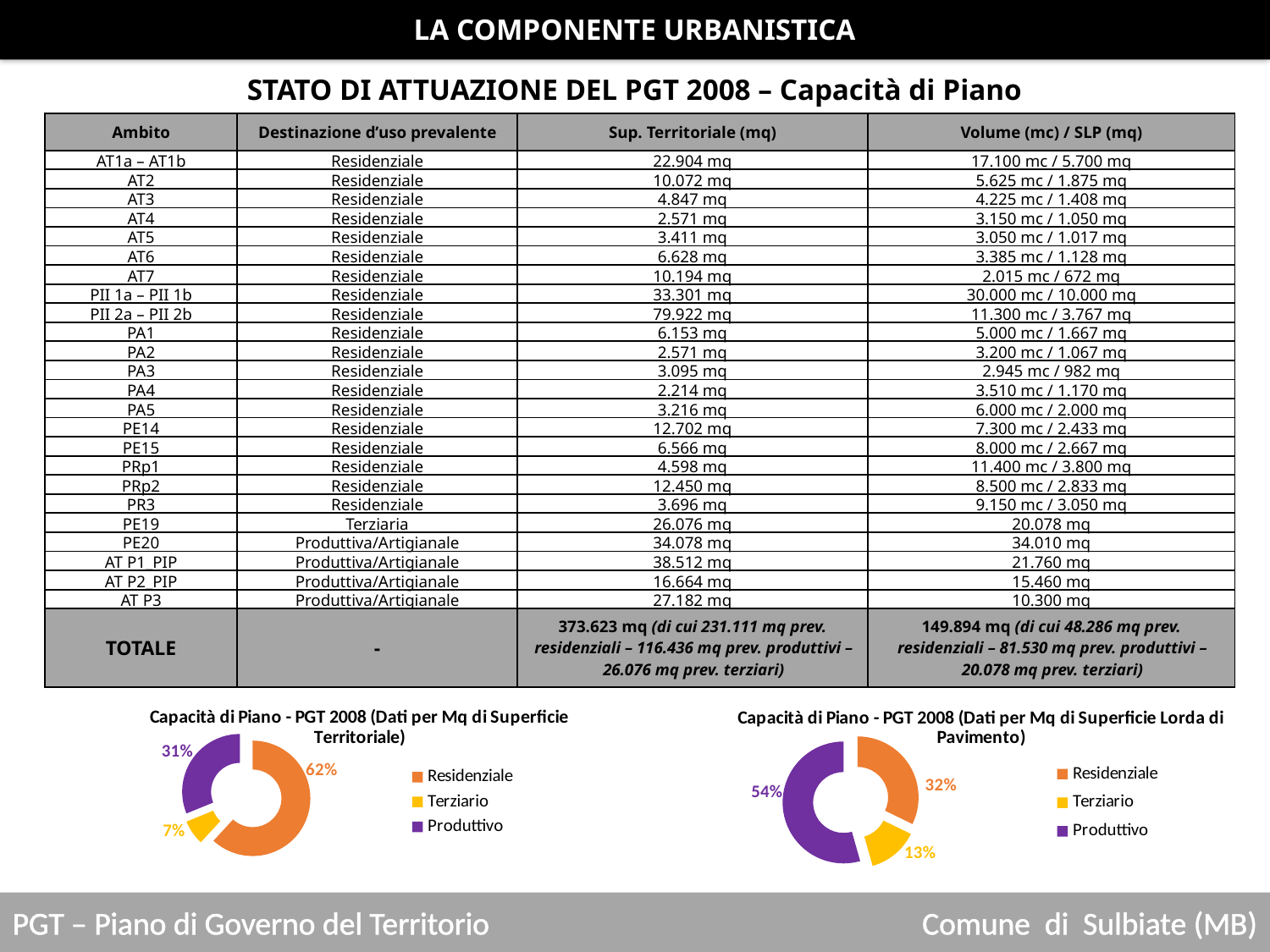
In the left chart (Dati per Mq di Superficie Territoriale), which is larger, Produttivo or Terziario? Produttivo In the left chart (Dati per Mq di Superficie Territoriale), what share does Produttivo have? 31% In the left chart (Dati per Mq di Superficie Territoriale), what share does Terziario have? 7% In the left chart (Dati per Mq di Superficie Territoriale), which category has the largest share? Residenziale How many categories does the legend of the right chart (Dati per Mq di Superficie Lorda di Pavimento) list? 3 In the right chart (Dati per Mq di Superficie Lorda di Pavimento), what share does Residenziale have? 32% In the right chart (Dati per Mq di Superficie Lorda di Pavimento), what is the difference between the Produttivo and Residenziale shares? 22% In the right chart (Dati per Mq di Superficie Lorda di Pavimento), which category has the smallest share? Terziario What kind of chart is the left chart (Dati per Mq di Superficie Territoriale)? Doughnut (pie) chart